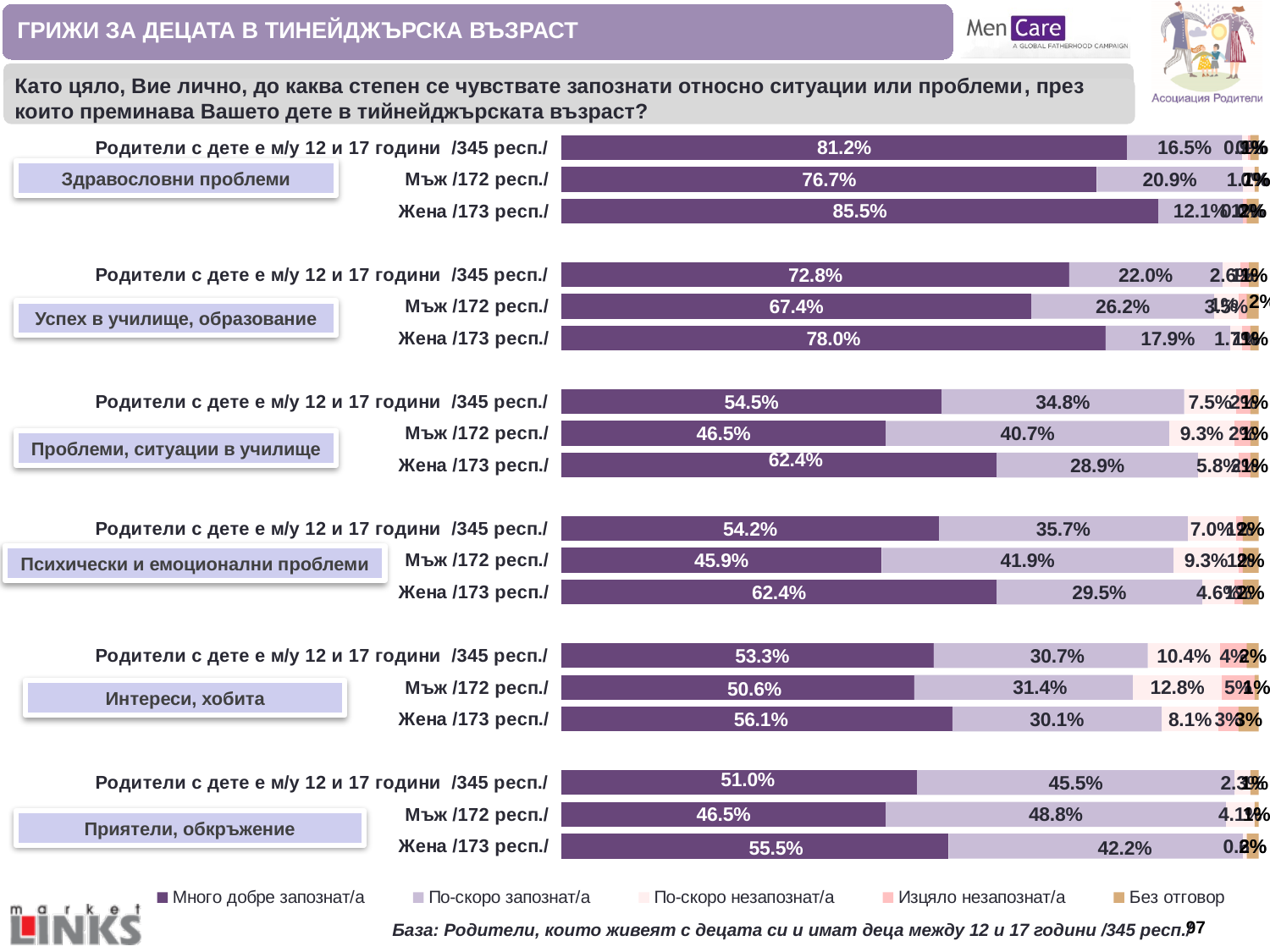
In the "Здравословни проблеми" chart, what is the "По-скоро запознат/а" value for Мъж /172 респ./? 20.9% What type of chart is used on this slide? Stacked bar chart In the "Приятели, обкръжение" chart, what is the "По-скоро запознат/а" value for Мъж /172 респ./? 48.8% How many rows (respondent groups) are shown in the "Приятели, обкръжение" chart? 3 In the "Успех в училище, образование" chart, what is the "Много добре запознат/а" value for Жена /173 респ./? 78.0% In the "Проблеми, ситуации в училище" chart, what is the "По-скоро незапознат/а" value for Мъж /172 респ./? 9.3% In the "Интереси, хобита" chart, which group has the higher "Много добре запознат/а" value: Мъж /172 респ./ or Жена /173 респ./? Жена /173 респ./ Across all six charts, which topic has the highest "Много добре запознат/а" value for all parents (345 resp.)? Здравословни проблеми How many series does the legend list? 5 In the "Здравословни проблеми" chart, what percentage of all parents (345 resp.) answered "Много добре запознат/а"? 81.2% In the "Психически и емоционални проблеми" chart, which of the three rows has the lowest "Много добре запознат/а" value? Мъж /172 респ./ In the "Здравословни проблеми" chart, what is the difference between the "Много добре запознат/а" values for Жена /173 респ./ and Мъж /172 респ./? 8.8%